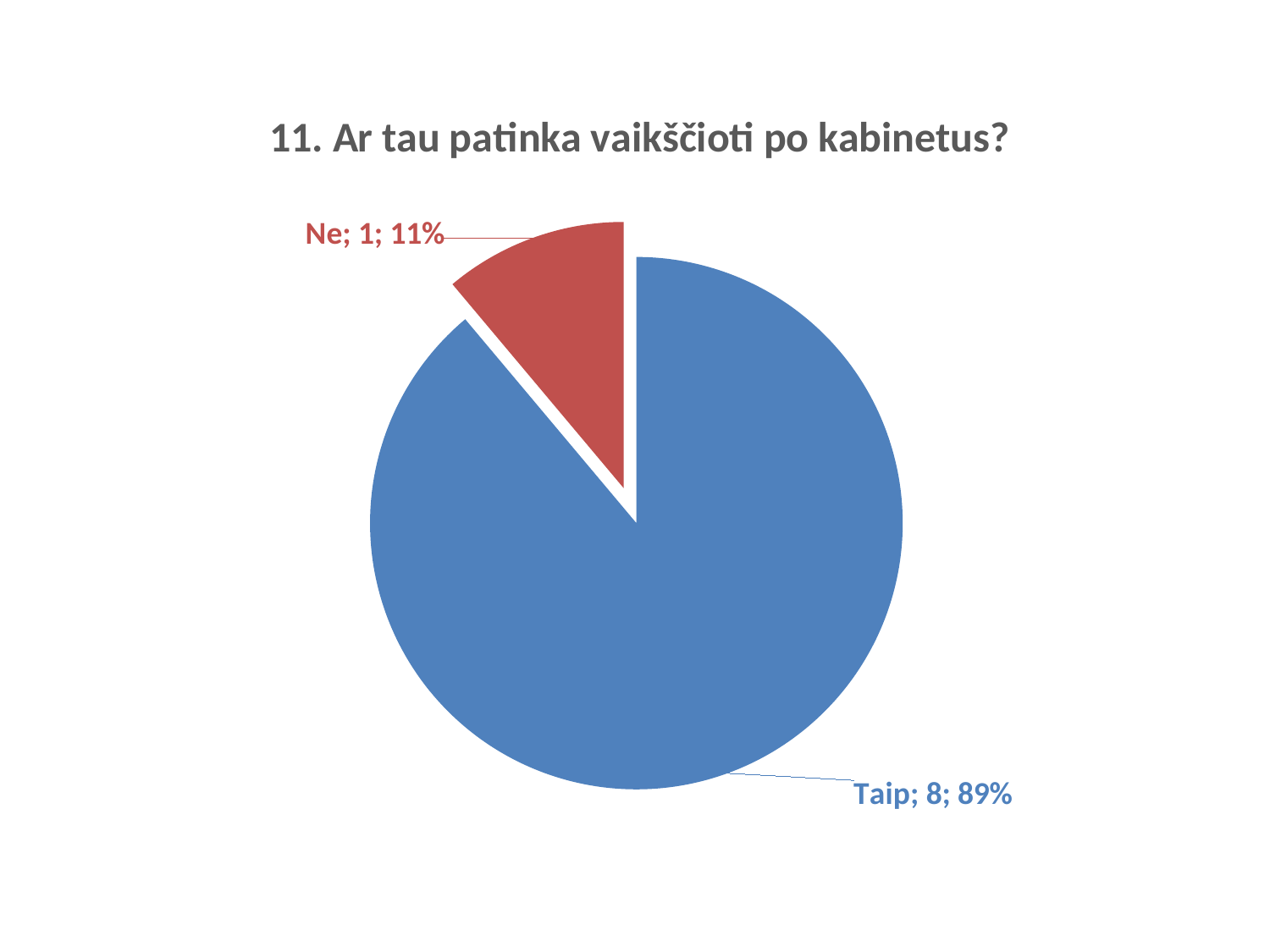
Which slice is the smallest? Ne What kind of chart is shown on the slide? pie chart What is the difference in count between the "Taip" and "Ne" slices? 7 What colour is the "Ne" slice? red How many responses does the "Ne" slice represent? 1 Which slice is larger, "Taip" or "Ne"? Taip What share of the pie does the "Ne" slice take? 11% How many slices does the pie chart have? 2 Which slice is the largest? Taip What is the title of the chart? 11. Ar tau patinka vaikščioti po kabinetus? What share of the pie does the "Taip" slice take? 89% How many responses does the "Taip" slice represent? 8